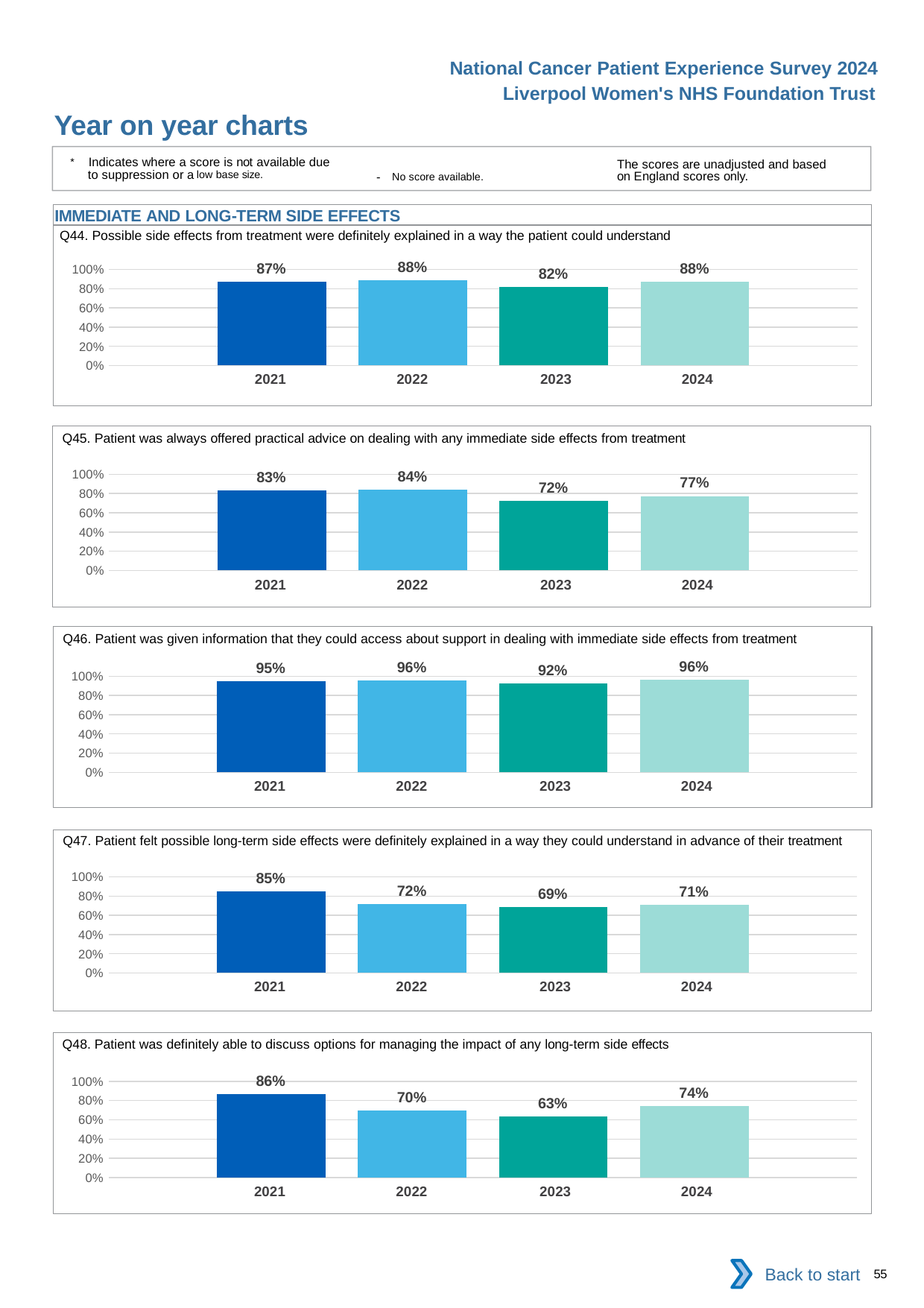
In the Q47 chart, is the value for 2023 greater or less than 80%? less In the Q47 chart, which year has the highest value? 2021 In the Q48 chart, does the value rise or fall from 2021 to 2022? Fall In the Q46 chart, what is the value for 2021? 95% In the Q44 chart, what is the value for 2023? 82% In the Q45 chart, is the value for 2024 larger than the value for 2023? Yes In the Q48 chart, what is the difference between the 2021 and 2023 values? 23% What kind of chart is the Q46 chart? Bar chart How many charts are shown on the slide? 5 How many years are shown in the Q44 chart? 4 In the Q45 chart, which year has the lowest value? 2023 In the Q44 chart, what is the difference between the 2022 and 2023 values? 6%